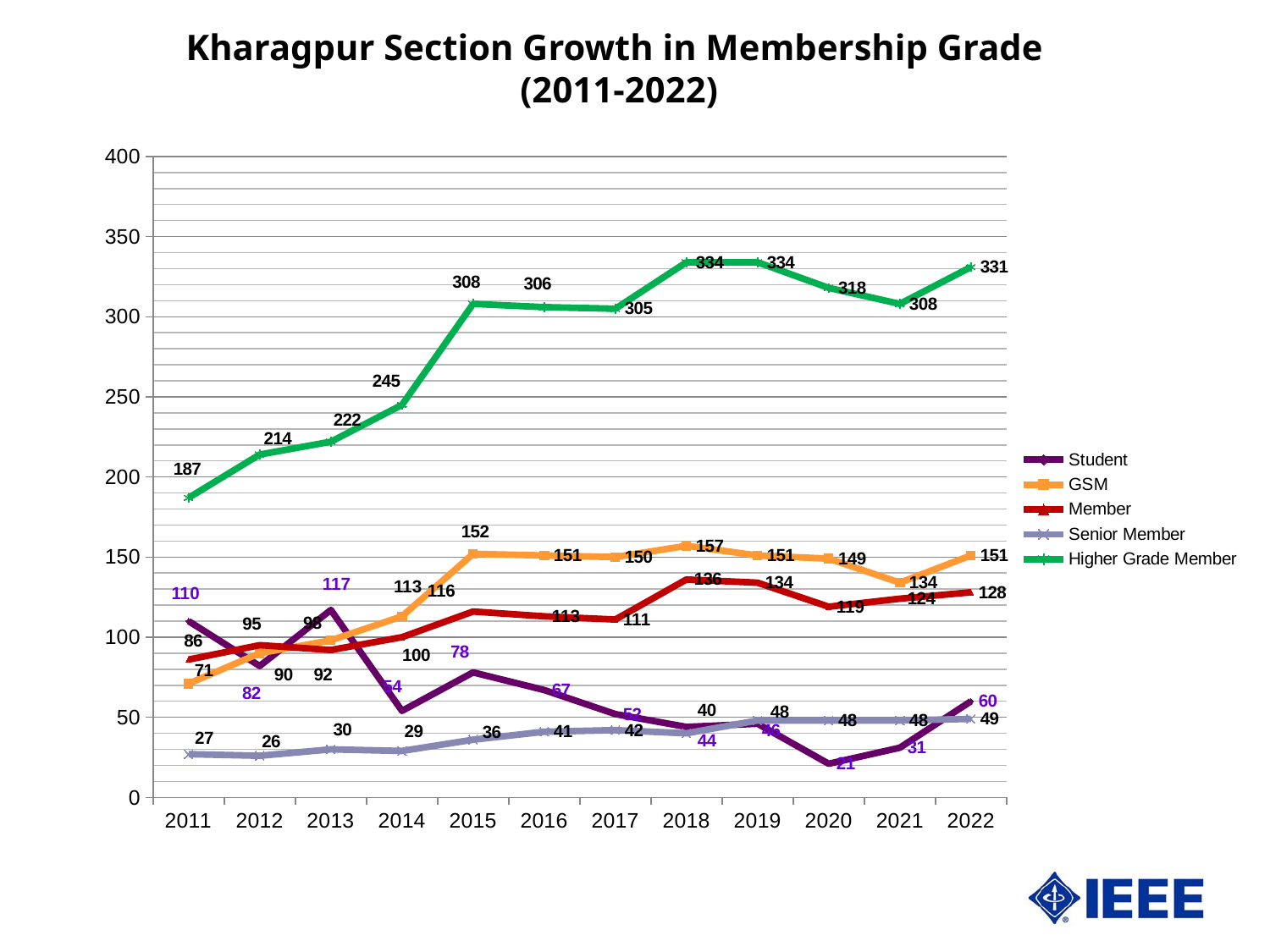
In 2011, which is larger: the Member value or the GSM value? Member Does the Higher Grade Member series rise or fall from 2011 to 2015? rise What is the Student value for 2020? 21 What is the Higher Grade Member value for 2015? 308 In which year is the GSM series at its highest? 2018 How many series does the legend list? 5 What is the difference between the Higher Grade Member values for 2022 and 2011? 144 How many years are plotted along the x axis? 12 What is the Senior Member value for 2022? 49 What is the GSM value for 2018? 157 In which year is the Student series at its lowest? 2020 What kind of chart is shown on the slide? line chart